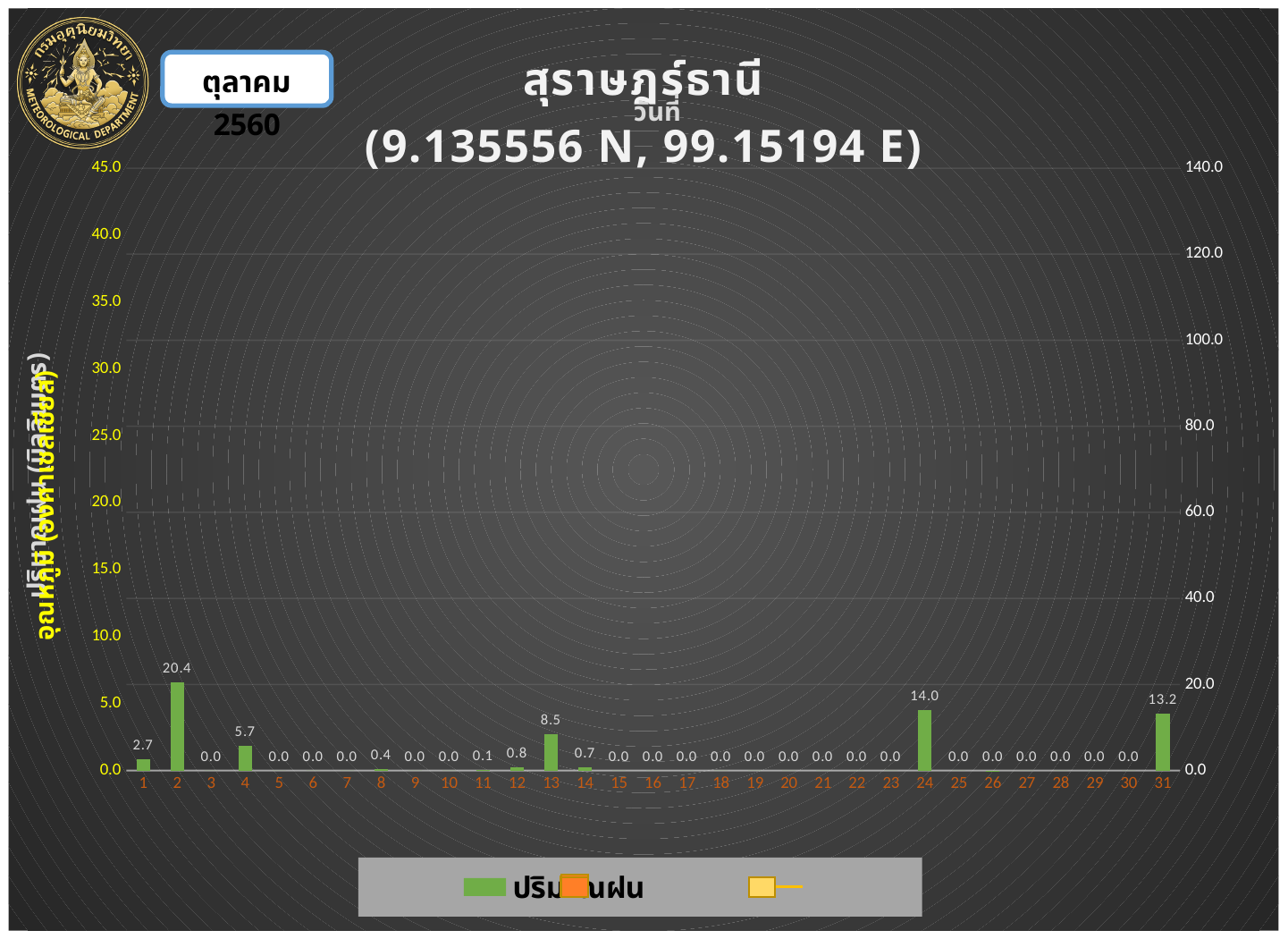
What is the value for day 24? 14.0 Which is larger, the value for day 13 or the value for day 4? day 13 What coordinates are given in the chart title? 9.135556 N, 99.15194 E What is the difference between the values for day 2 and day 24? 6.4 What kind of chart is shown on the slide? bar chart What is the value for day 2? 20.4 What is the value for day 13? 8.5 What is the value for day 31? 13.2 What is the difference between the values for day 24 and day 31? 0.8 Which day has the highest value? 2 What is the value for day 4? 5.7 How many days are shown on the x axis? 31